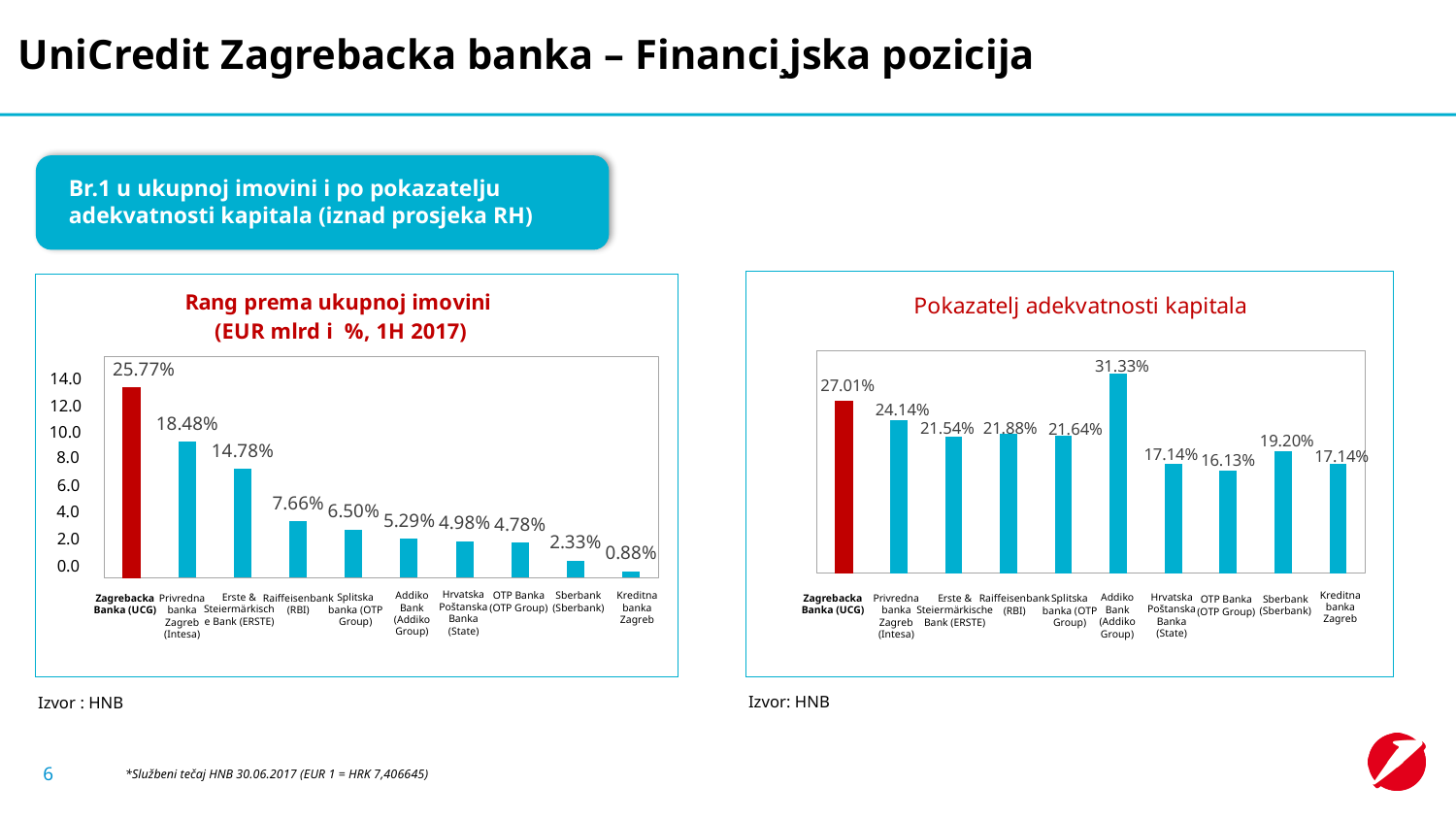
In the chart 'Pokazatelj adekvatnosti kapitala', what is the value for Zagrebacka Banka (UCG)? 27.01% In the chart 'Pokazatelj adekvatnosti kapitala', what is the value for Addiko Bank (Addiko Group)? 31.33% In the chart 'Rang prema ukupnoj imovini', how many banks are shown? 10 In the chart 'Rang prema ukupnoj imovini', is the bar for Privredna banka Zagreb (Intesa) greater or less than 8.0 on the axis? greater What type of chart is the chart 'Pokazatelj adekvatnosti kapitala'? Bar chart In the chart 'Pokazatelj adekvatnosti kapitala', what is the difference between the values for Addiko Bank and Zagrebacka Banka? 4.32% In the chart 'Pokazatelj adekvatnosti kapitala', which bank has the lowest value? OTP Banka (OTP Group) In the chart 'Rang prema ukupnoj imovini', what is the data label shown for Zagrebacka Banka (UCG)? 25.77% In the chart 'Rang prema ukupnoj imovini', which bank has the lowest value? Kreditna banka Zagreb In the chart 'Rang prema ukupnoj imovini', what is the data label shown for Raiffeisenbank (RBI)? 7.66% In the chart 'Pokazatelj adekvatnosti kapitala', which is larger: the value for Privredna banka Zagreb (Intesa) or for Sberbank? Privredna banka Zagreb (Intesa) In the chart 'Pokazatelj adekvatnosti kapitala', which bank has the highest value? Addiko Bank (Addiko Group)